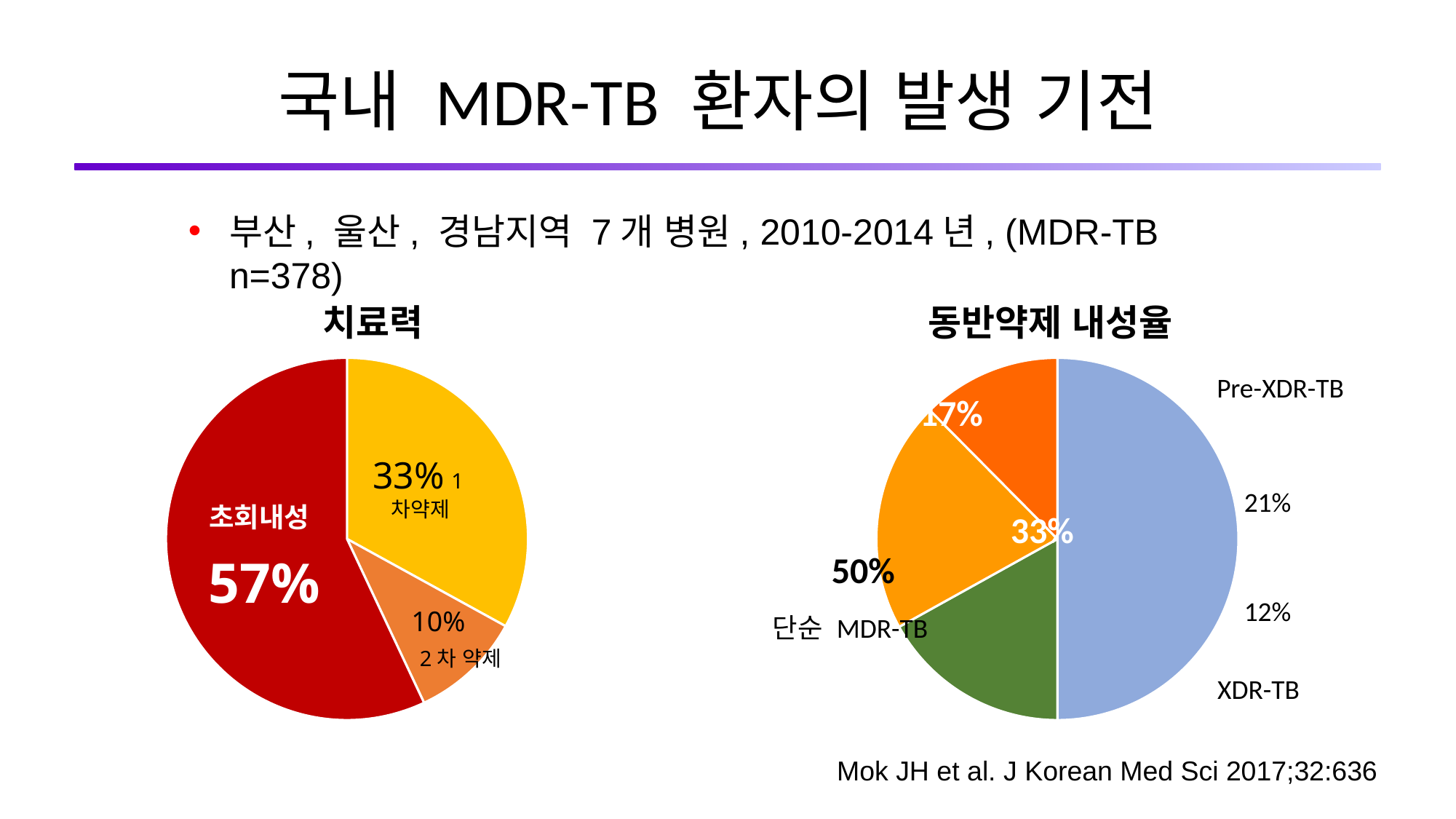
How many slices does the right chart (동반약제 내성율) have? 4 In the left chart (치료력), which slice is the largest? 초회내성 In the left chart (치료력), what is the difference in percentage points between 초회내성 and 1차약제? 24 percentage points In the left chart (치료력), which is larger, 1차약제 or 2차 약제? 1차약제 How many slices does the left chart (치료력) have? 3 In the left chart (치료력), what percentage is shown for 1차약제? 33% What kind of chart is the right chart titled 동반약제 내성율? pie chart In the left chart (치료력), which slice is the smallest? 2차 약제 In the left chart (치료력), what percentage is shown for 초회내성? 57% In the left chart (치료력), what percentage is shown for 2차 약제? 10% What is the title of the right chart? 동반약제 내성율 What kind of chart is the left chart titled 치료력? pie chart